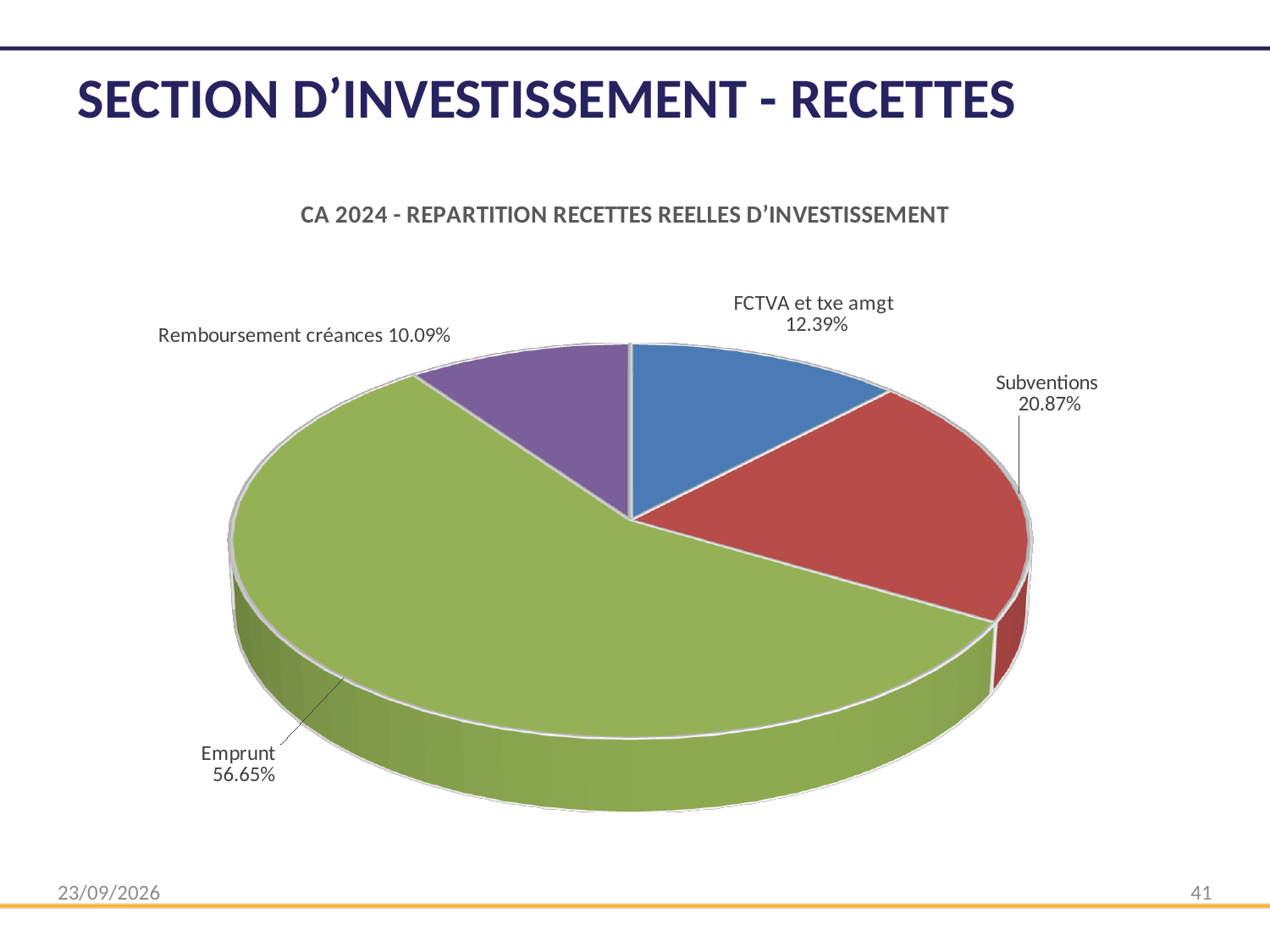
What kind of chart is shown on the slide? Pie chart Which category has the largest share of the pie? Emprunt What is the value shown for FCTVA et txe amgt? 12.39% What is the title of the chart? CA 2024 - REPARTITION RECETTES REELLES D'INVESTISSEMENT Which category has the smallest share of the pie? Remboursement créances What is the value shown for Subventions? 20.87% What share of the pie does Emprunt represent? 56.65% What colour is the Emprunt slice? Green Which is larger, the share of Subventions or the share of Remboursement créances? Subventions How many categories are shown in the pie chart? 4 What is the value shown for Remboursement créances? 10.09% What is the difference between the shares of Subventions and FCTVA et txe amgt? 8.48%